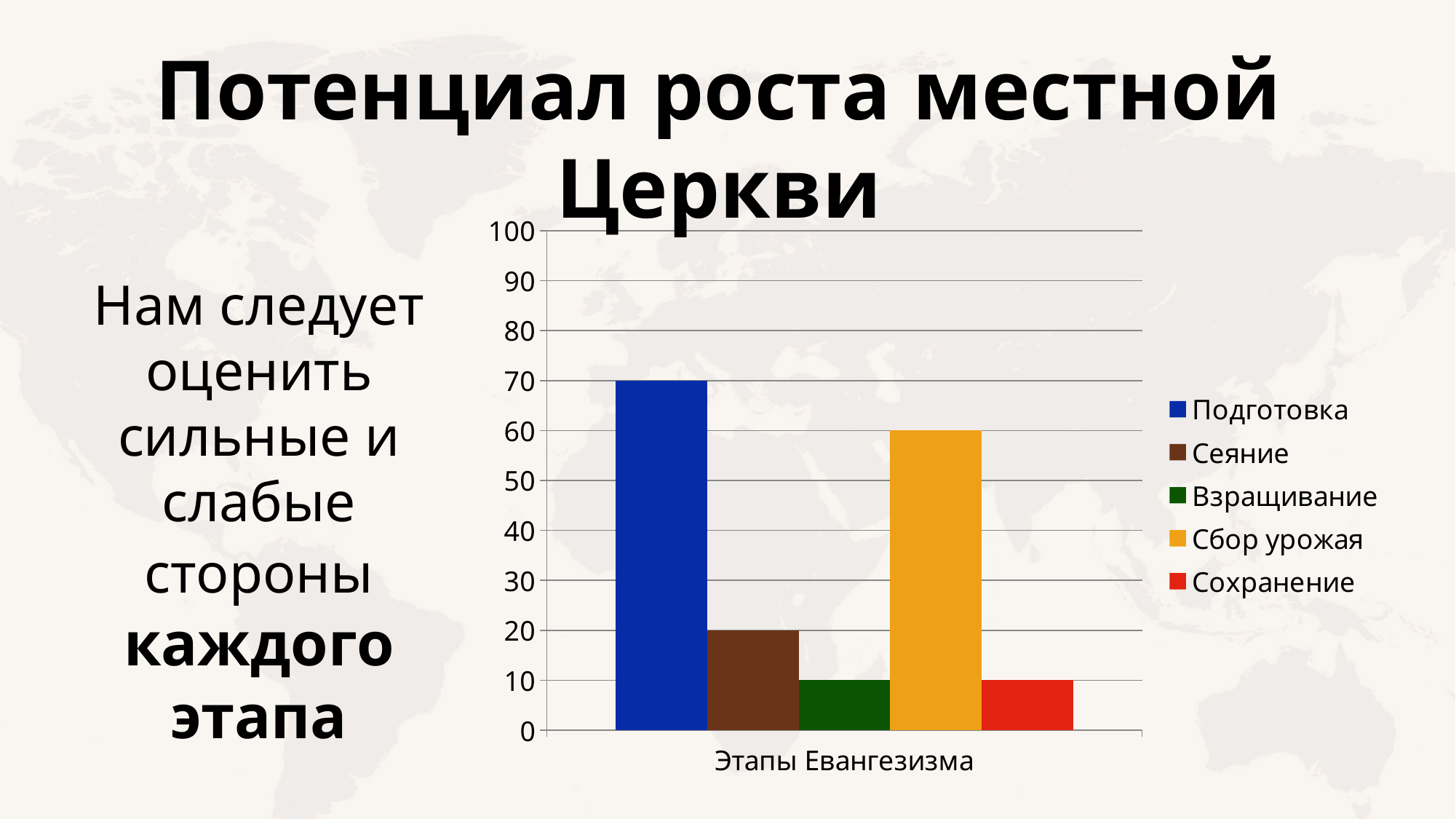
What is the value for Сеяние? 20 What colour is the bar for Сохранение? red What is the difference between the values for Подготовка and Сбор урожая? 10 How many series does the legend list? 5 What is the value for Сбор урожая? 60 Which is larger, the value for Сеяние or the value for Сохранение? Сеяние What is the value for Подготовка? 70 Is the value for Сбор урожая greater or less than 50? greater Which series has the highest value? Подготовка What kind of chart is shown on the slide? bar chart What is the label on the x axis of the chart? Этапы Евангезизма What is the value for Взращивание? 10